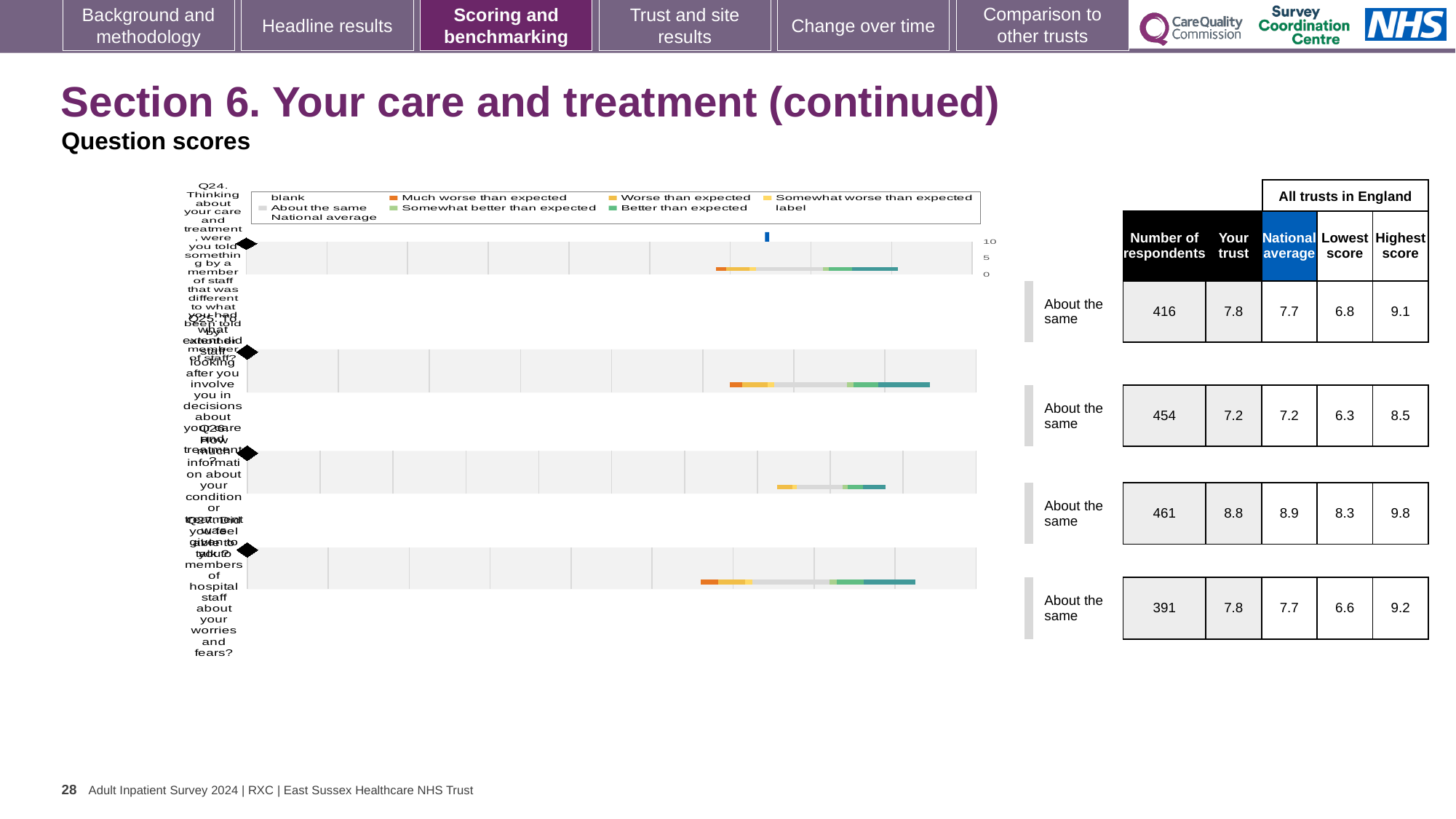
In the table beside the charts, what is the highest score for the third row? 9.8 In the table beside the charts, what is the 'Your trust' score for the second row? 7.2 In the table beside the charts, which row has the highest 'Your trust' score? the third row (8.8) In the table beside the charts, what is the number of respondents for the first row? 416 How many benchmarking charts are shown on the slide? 4 What kind of chart is used for the question scores on this slide? bar chart In the table beside the charts, which row has the fewest respondents? the fourth row (391) What is the maximum value shown on the score axis of the top chart? 10 In the table beside the charts, what is the difference between the highest score and the lowest score in the first row? 2.3 In the table beside the charts, for the third row, which is larger: the 'Your trust' score or the national average? National average In the table beside the charts, what is the lowest score for the fourth row? 6.6